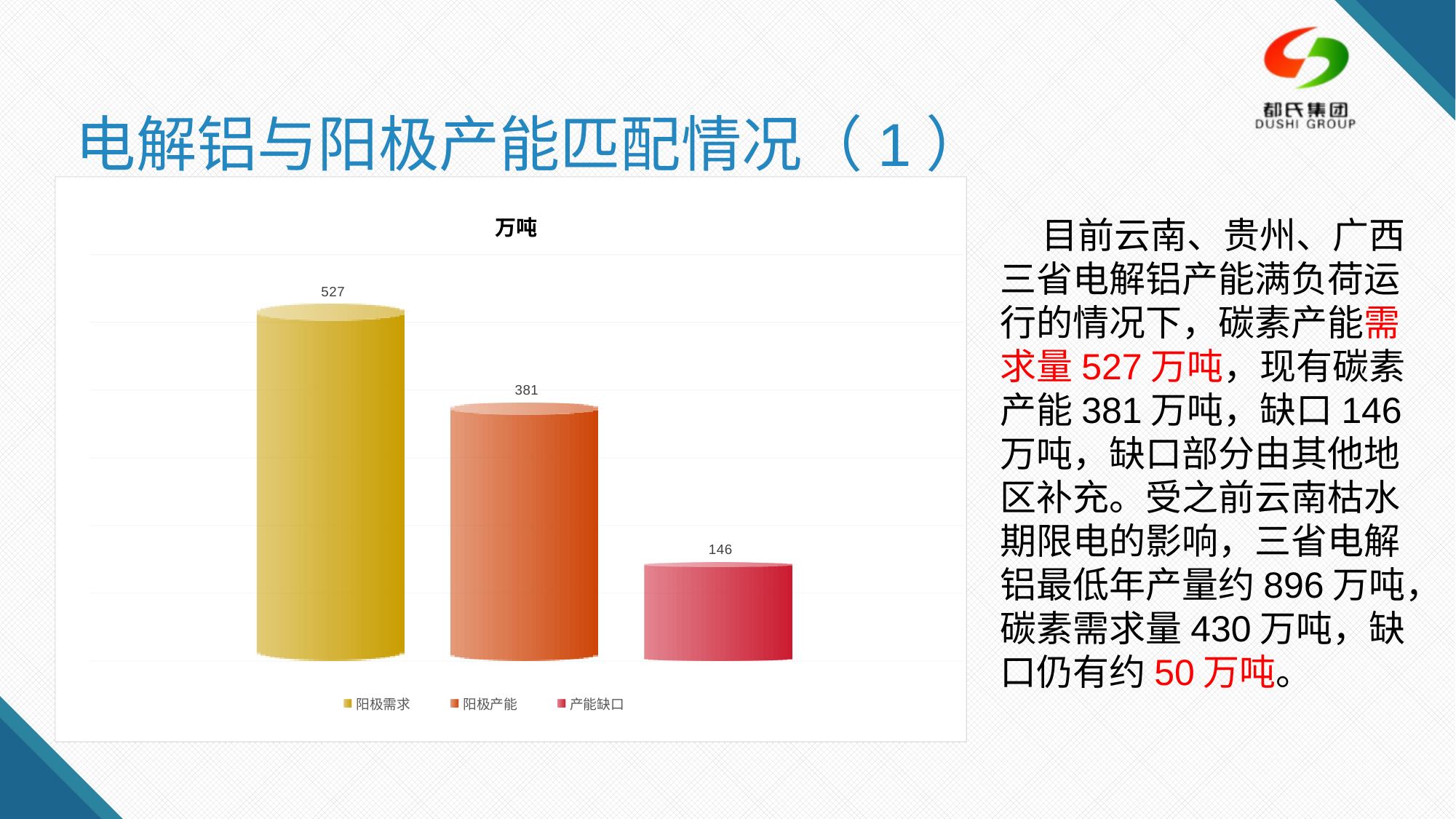
What is the title of the chart? 万吨 What is the difference between 阳极需求 and 阳极产能? 146 Which series has the lowest value in the chart? 产能缺口 What is the value for 阳极需求 in the chart? 527 What is the value for 产能缺口 in the chart? 146 Which is larger, 阳极产能 or 产能缺口? 阳极产能 How many series does the legend list? 3 What kind of chart is shown on the slide? Bar chart What is the value for 阳极产能 in the chart? 381 Which series has the highest value in the chart? 阳极需求 What is the difference between 阳极产能 and 产能缺口? 235 How many bars are plotted in the chart? 3